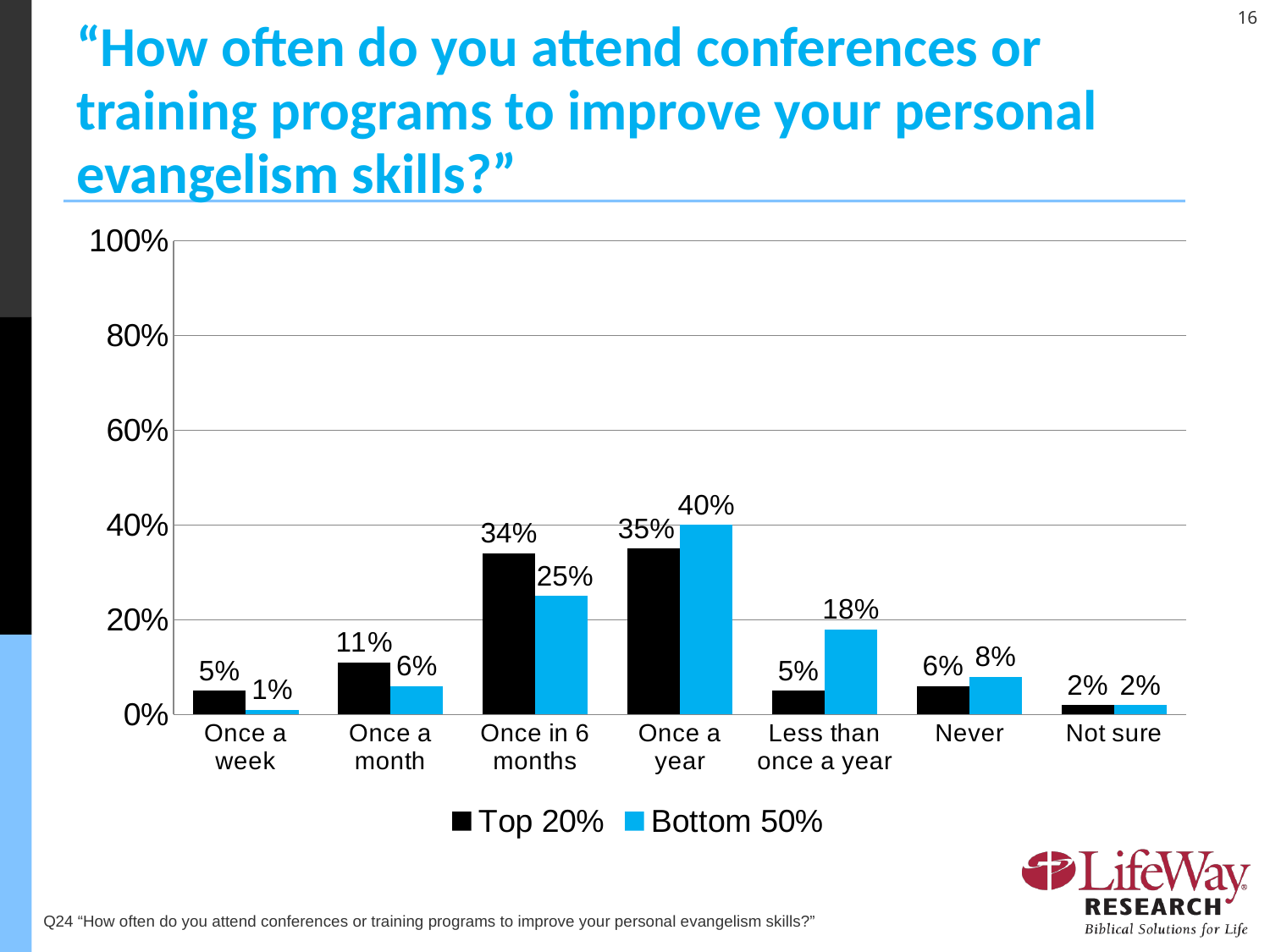
How many series does the legend list? 2 What kind of chart is shown on the slide? Bar chart What is the difference between the Top 20% and Bottom 50% values for 'Once in 6 months'? 9% Which category has the highest value for the Bottom 50% series? Once a year Is the Bottom 50% value for 'Once a year' greater or less than 20%? greater What is the value for Top 20% in the 'Once in 6 months' category? 34% For 'Less than once a year', which series has the larger value, Top 20% or Bottom 50%? Bottom 50% What is the value for Bottom 50% in the 'Once a week' category? 1% How many categories are shown on the x axis? 7 Which category has the lowest value for the Top 20% series? Not sure What is the value for Bottom 50% in the 'Less than once a year' category? 18% What colour represents the Bottom 50% series? Blue